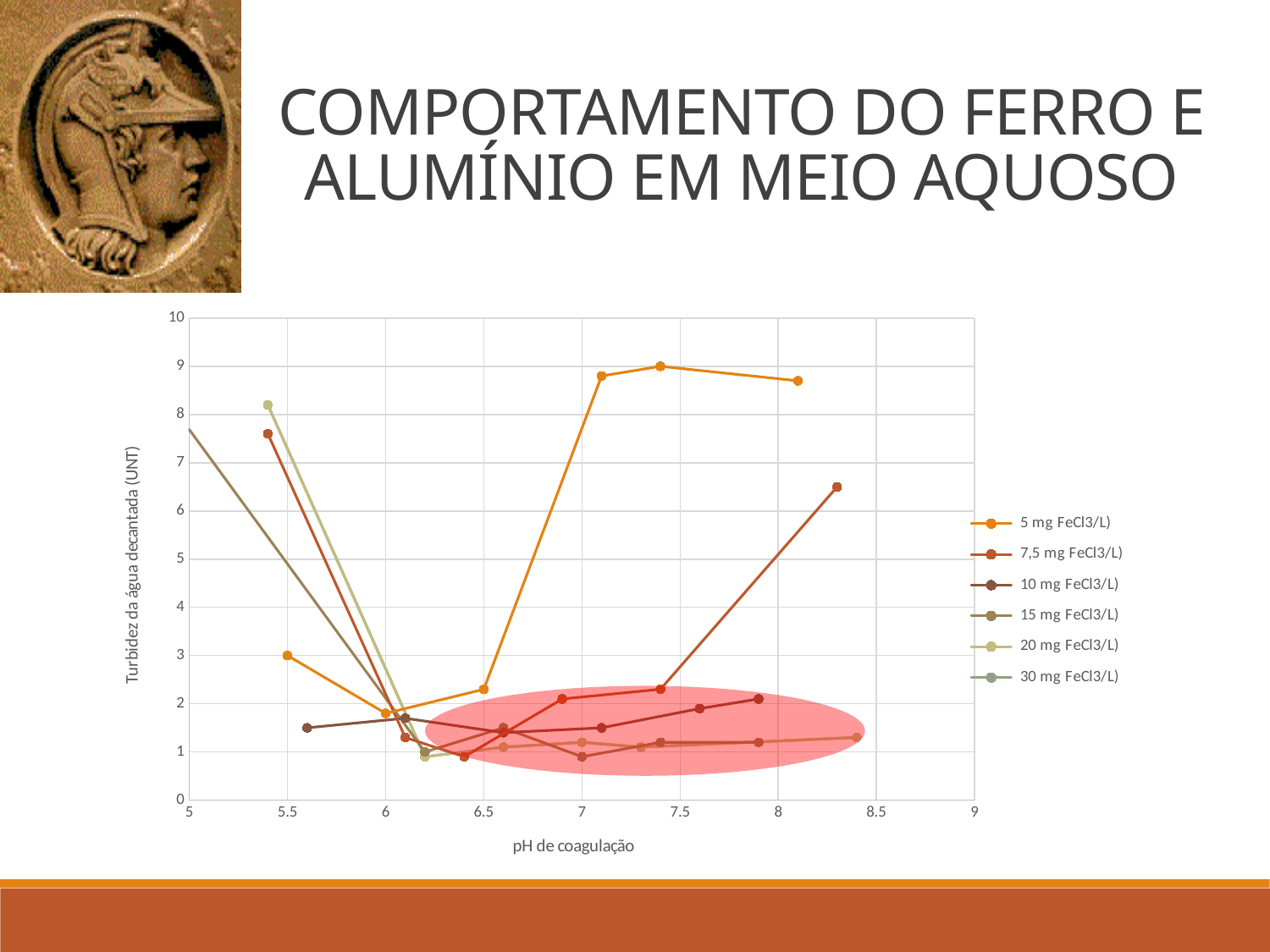
Which series reaches the highest turbidity value on the chart? 5 mg FeCl3/L What is the title of the x axis? pH de coagulação Is the turbidity for the 10 mg FeCl3/L series at pH 5.6 greater or less than 2? less What is the title of the y axis? Turbidez da água decantada (UNT) What kind of chart is shown on the slide? line chart At pH 7.4, which series has the higher turbidity: 5 mg FeCl3/L or 7,5 mg FeCl3/L? 5 mg FeCl3/L How many series does the legend list? 6 Is the turbidity for the 5 mg FeCl3/L series at pH 7.4 greater or less than 8? greater Does the turbidity for the 7,5 mg FeCl3/L series rise or fall between pH 5.4 and pH 6.4? fall Is the turbidity for the 20 mg FeCl3/L series at pH 5.4 greater or less than 8? greater